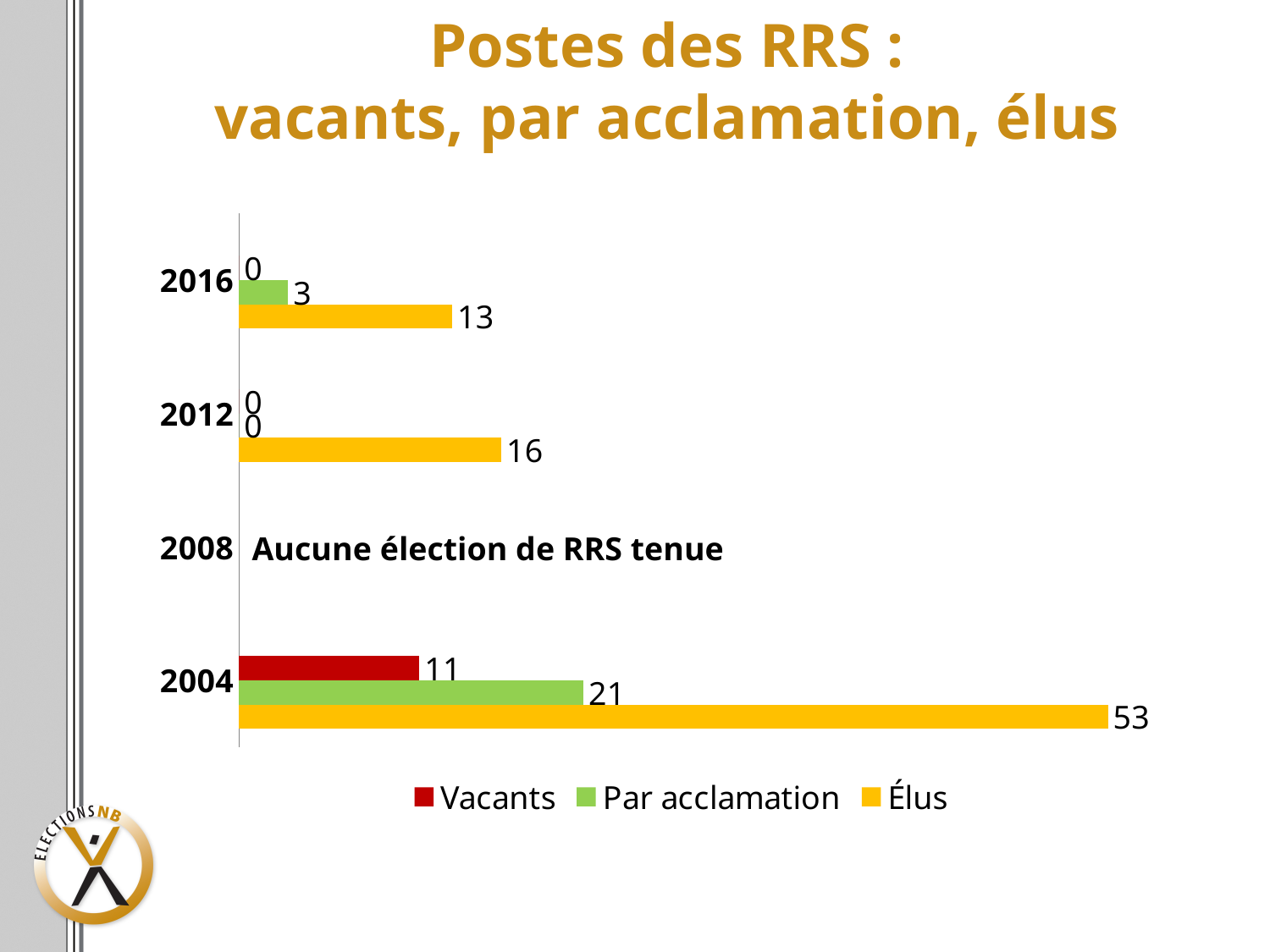
What text is shown for the year 2008 instead of bars? Aucune élection de RRS tenue What is the value for Élus in 2012? 16 What is the value for Par acclamation in 2016? 3 What is the total of Vacants, Par acclamation and Élus for 2004? 85 How many series does the legend list? 3 Which is larger in 2004, Par acclamation or Vacants? Par acclamation Which year has the highest value for Élus? 2004 What kind of chart is shown? Bar chart What is the difference between the Élus values for 2012 and 2016? 3 Which year has the lowest value for Élus among the years with bars? 2016 What is the value for Vacants in 2004? 11 What is the value for Élus in 2004? 53